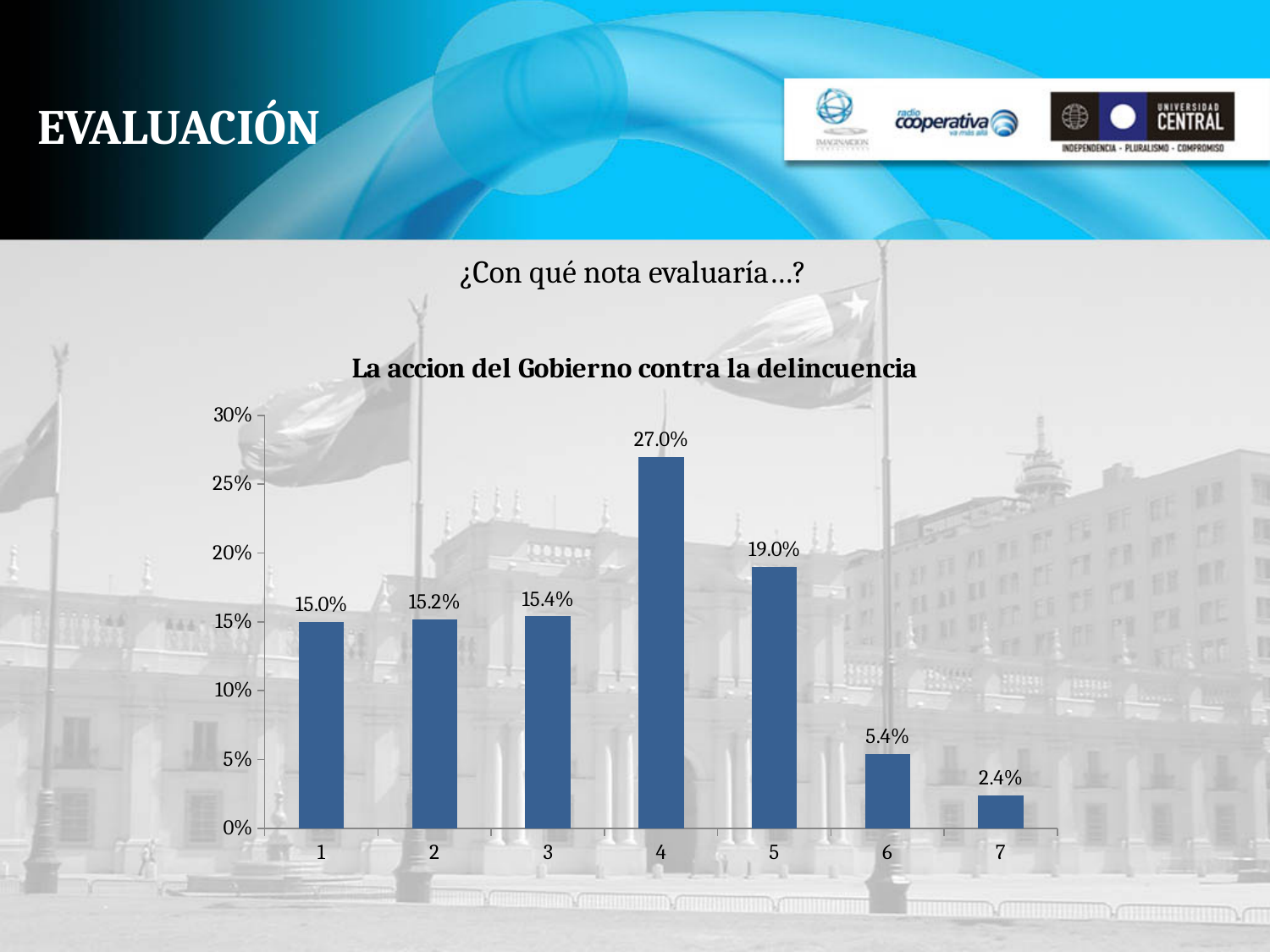
Is the value for category 6 greater or less than 10%? less What kind of chart is shown on the slide? bar chart What is the title of the chart? La accion del Gobierno contra la delincuencia What is the difference between the values for category 4 and category 5? 8.0% How many categories are shown on the x axis? 7 Which category has the highest value? 4 Which category has the lowest value? 7 What is the value for category 1? 15.0% What is the value for category 4? 27.0% What is the difference between the values for category 6 and category 7? 3.0% Which is larger, the value for category 5 or the value for category 3? 5 What is the value for category 7? 2.4%